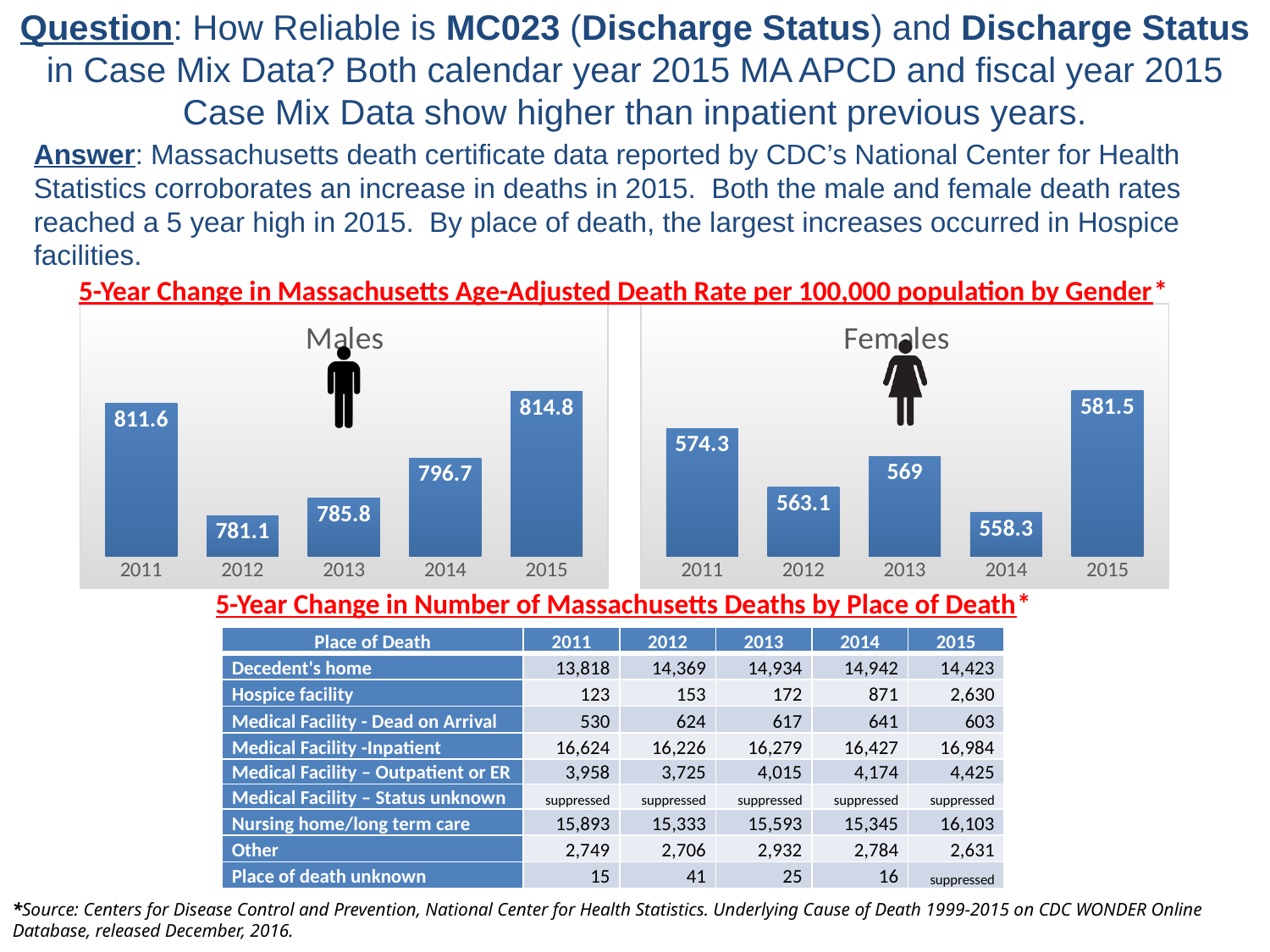
In the Males chart, is the death rate higher in 2013 or 2014? 2014 In the Females chart, which year has the lowest death rate? 2014 In the Females chart, is the death rate higher in 2012 or 2013? 2013 In the Males chart, what is the difference between the 2015 and 2011 death rates? 3.2 In the Females chart, what is the age-adjusted death rate for 2014? 558.3 How many years are shown in the Males chart? 5 In the Males chart, does the death rate rise or fall from 2012 to 2015? Rise In the Males chart, what is the age-adjusted death rate for 2015? 814.8 What type of chart is the Females chart? Bar chart In the Females chart, what is the difference between the 2015 and 2014 death rates? 23.2 In the Females chart, which year has the highest death rate? 2015 In the Males chart, which year has the lowest death rate? 2012